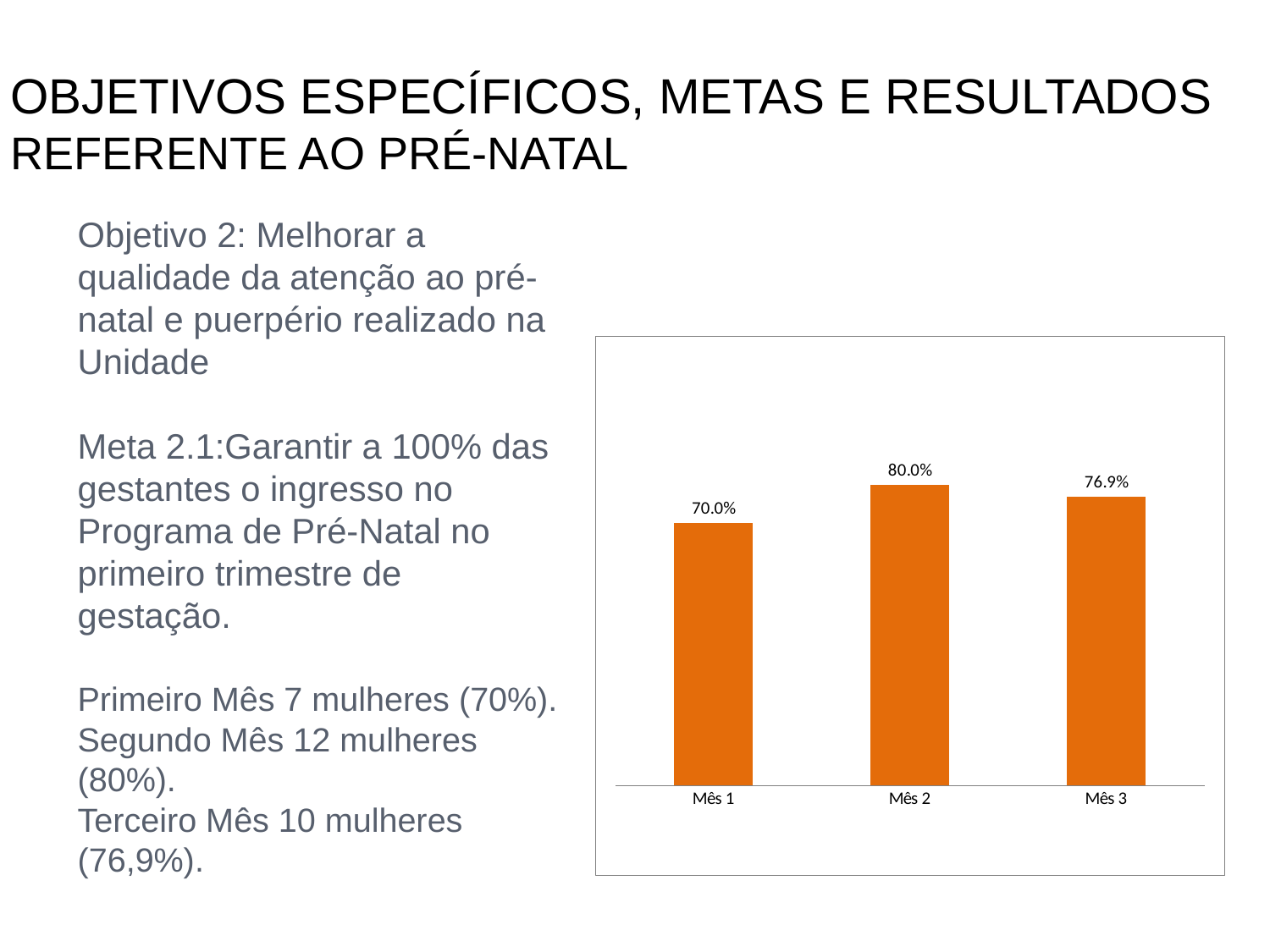
Which category has the lowest value? Mês 1 What kind of chart is shown on the slide? Bar chart Which is larger, the value for Mês 3 or the value for Mês 1? Mês 3 What is the difference between the values for Mês 2 and Mês 3? 3.1% How many categories are shown on the x axis? 3 What is the difference between the values for Mês 2 and Mês 1? 10.0% Does the value rise or fall from Mês 1 to Mês 2? Rise What colour are the bars in the chart? Orange What is the value for Mês 3? 76.9% Which category has the highest value? Mês 2 What is the value for Mês 1? 70.0% What is the value for Mês 2? 80.0%